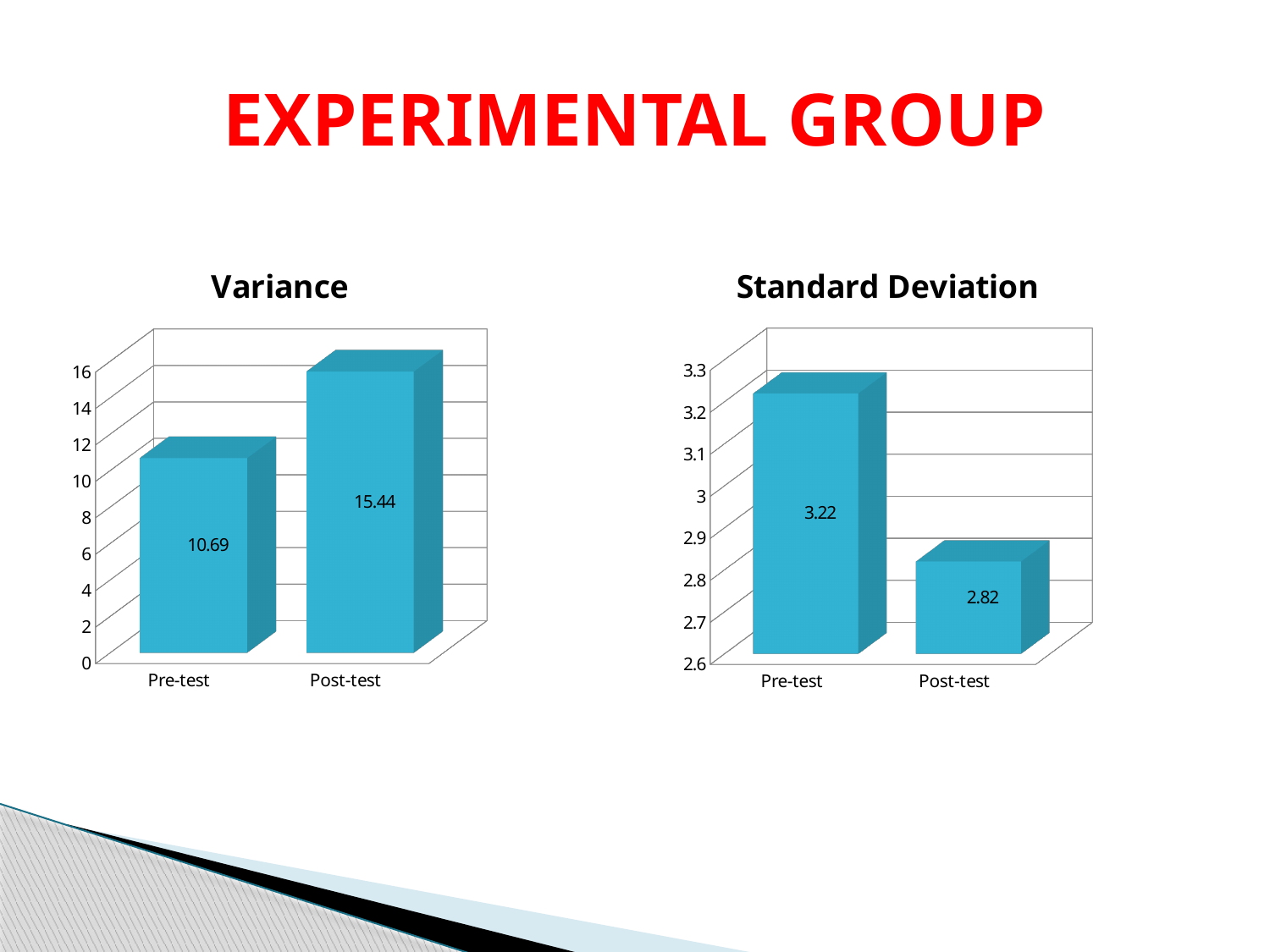
In the Standard Deviation chart, what is the difference between the Pre-test and Post-test values? 0.40 In the Standard Deviation chart, what is the value for Pre-test? 3.22 In the Standard Deviation chart, what is the value for Post-test? 2.82 In the Variance chart, which category has the highest value? Post-test What kind of chart is the Standard Deviation chart? Bar chart In the Variance chart, how many categories are shown on the x axis? 2 In the Variance chart, what is the difference between the Post-test and Pre-test values? 4.75 In the Standard Deviation chart, which is larger, Pre-test or Post-test? Pre-test In the Standard Deviation chart, which category has the lowest value? Post-test In the Variance chart, do the values rise or fall from Pre-test to Post-test? Rise In the Variance chart, what is the value for Post-test? 15.44 In the Variance chart, what is the value for Pre-test? 10.69